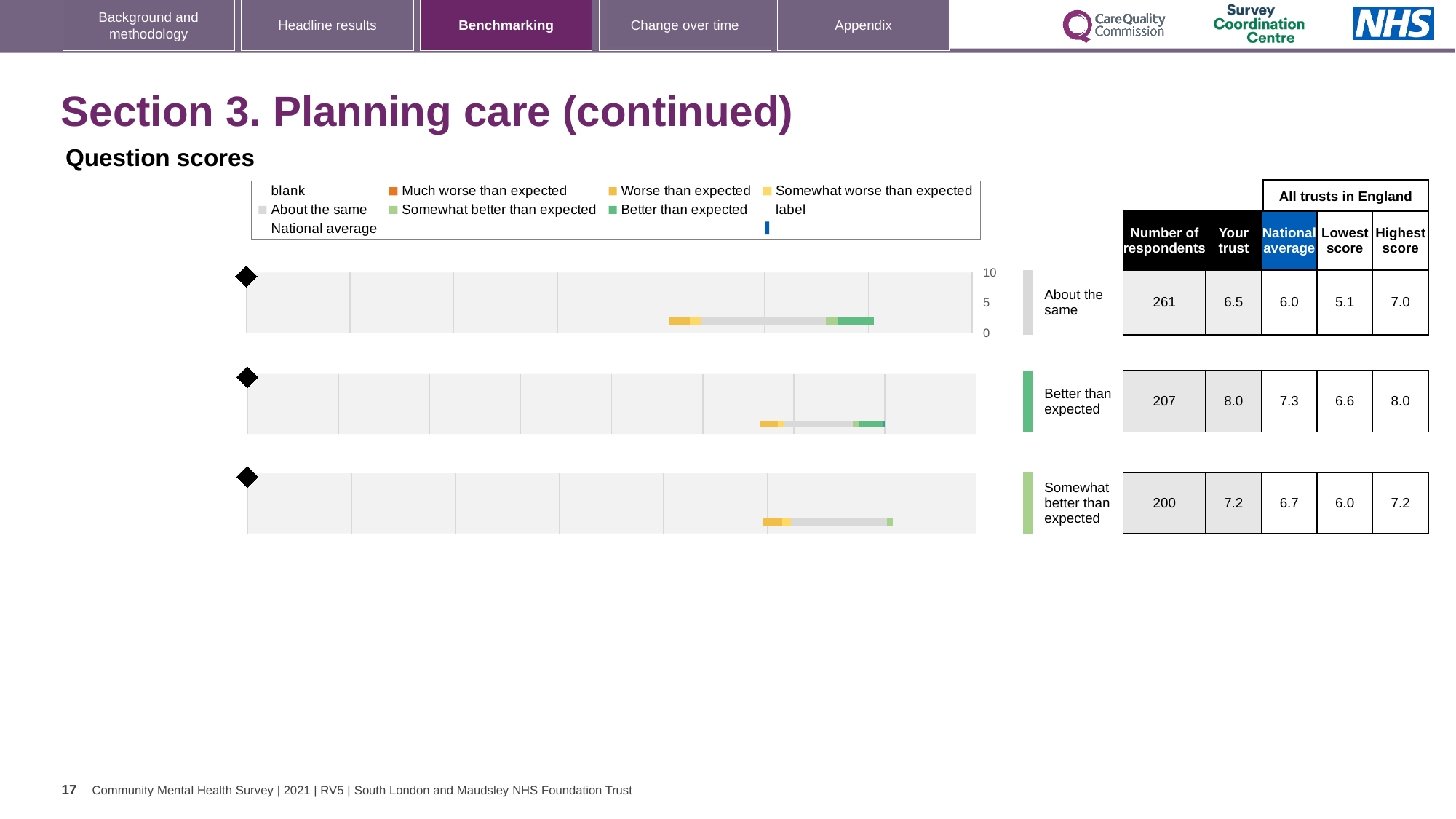
For the top chart (About the same), what is the lowest score among all trusts in England? 5.1 For the top chart (About the same), what is the 'Your trust' score? 6.5 How many question-score charts are shown on the slide? 3 What kind of chart is used for the three question scores on the slide? bar chart For the bottom chart (Somewhat better than expected), how many respondents are there? 200 For the bottom chart (Somewhat better than expected), which is larger: the 'Your trust' score or the national average? Your trust Which of the three charts has the highest 'Your trust' score? Better than expected For the middle chart (Better than expected), what is the national average? 7.3 What colour does the legend use for 'Better than expected'? green What is the maximum value shown on the score axis of the top chart? 10 For the middle chart (Better than expected), what is the difference between the 'Your trust' score and the national average? 0.7 Which of the three charts has the lowest number of respondents? Somewhat better than expected